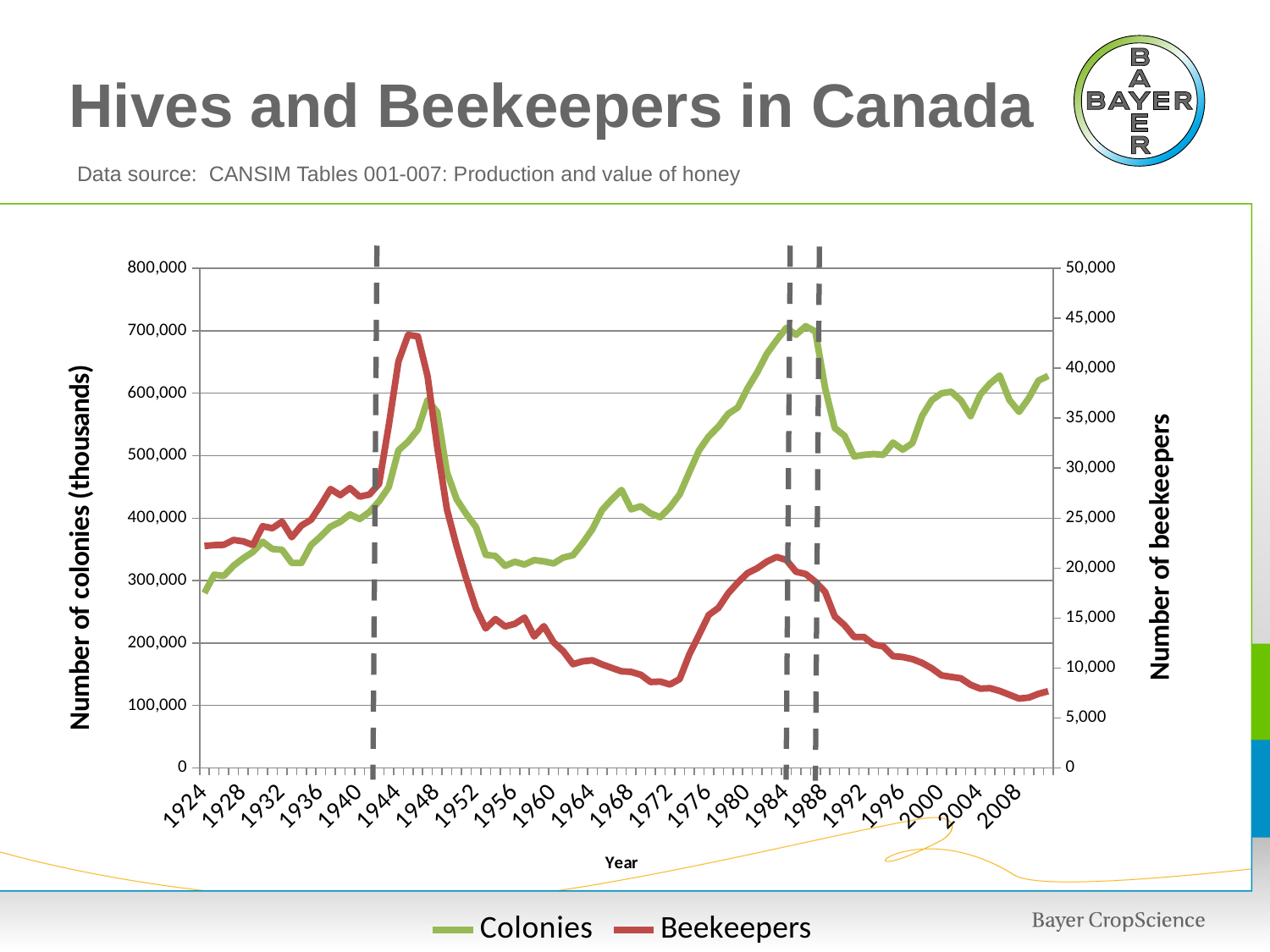
Does the Colonies series rise or fall between 1972 and 1984? rise Is the value for Colonies in 1924 greater or less than 400,000? less What kind of chart is shown on the slide? Line chart Is the value for Colonies in 1956 greater or less than 400,000? less What is the title of the chart on the slide? Hives and Beekeepers in Canada How many series does the legend list? 2 Is the value for Beekeepers in 1946 greater or less than 40,000? greater Which series is drawn in red? Beekeepers Does the Beekeepers series rise or fall between 1948 and 1956? fall